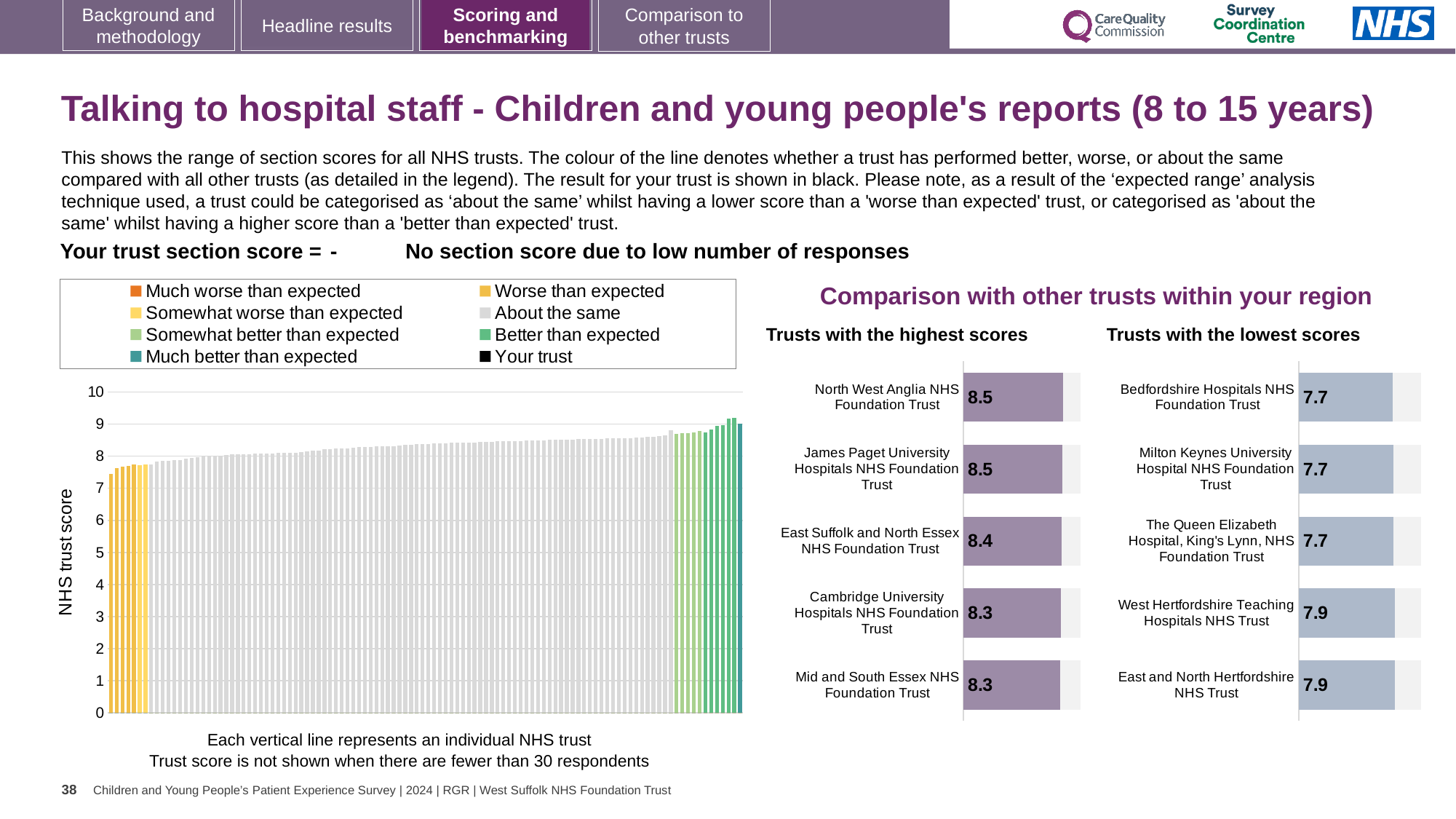
How many trusts are listed in the 'Trusts with the lowest scores' chart? 5 How many entries does the legend above the large chart on the left list? 8 In the large chart on the left, is the lowest trust score greater or less than 7? greater In the 'Trusts with the lowest scores' chart, what is the score for West Hertfordshire Teaching Hospitals NHS Trust? 7.9 What kind of chart is the large chart on the left showing the range of section scores for all NHS trusts? Bar chart What is the y-axis label of the large chart on the left? NHS trust score In the 'Trusts with the highest scores' chart, what is the score for East Suffolk and North Essex NHS Foundation Trust? 8.4 In the 'Trusts with the highest scores' chart, what score is shown for Cambridge University Hospitals NHS Foundation Trust? 8.3 In the 'Trusts with the lowest scores' chart, what is the score for Bedfordshire Hospitals NHS Foundation Trust? 7.7 In the 'Trusts with the highest scores' chart, what is the difference between the scores of North West Anglia NHS Foundation Trust and Mid and South Essex NHS Foundation Trust? 0.2 In the 'Trusts with the lowest scores' chart, which has the higher score: East and North Hertfordshire NHS Trust or Milton Keynes University Hospital NHS Foundation Trust? East and North Hertfordshire NHS Trust How many trusts are listed in the 'Trusts with the highest scores' chart? 5